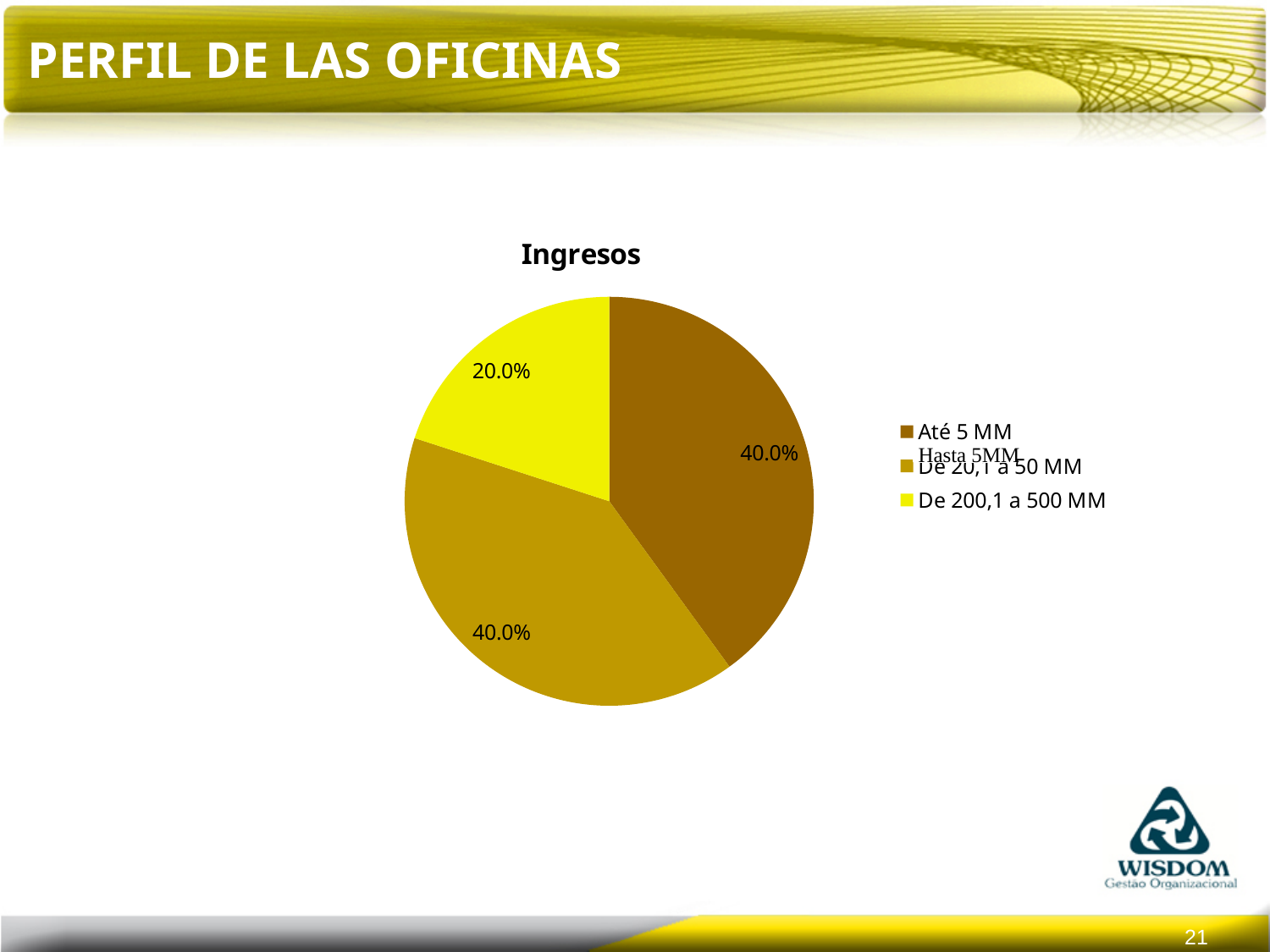
What percentage is shown for the 'De 200,1 a 500 MM' slice? 20.0% What colour is the 'De 200,1 a 500 MM' slice? yellow How many slices does the pie chart have? 3 What percentage is shown for the 'Até 5 MM' slice? 40.0% What kind of chart is shown on the slide? pie chart What is the title of the chart? Ingresos What is the difference between the 'Até 5 MM' slice and the 'De 200,1 a 500 MM' slice? 20.0% How many slices are labelled 40.0%? 2 How many entries does the legend list? 3 What share of the pie does 'De 200,1 a 500 MM' represent? 20.0% Which is larger, the 'Até 5 MM' slice or the 'De 200,1 a 500 MM' slice? Até 5 MM Which category has the smallest slice of the pie? De 200,1 a 500 MM